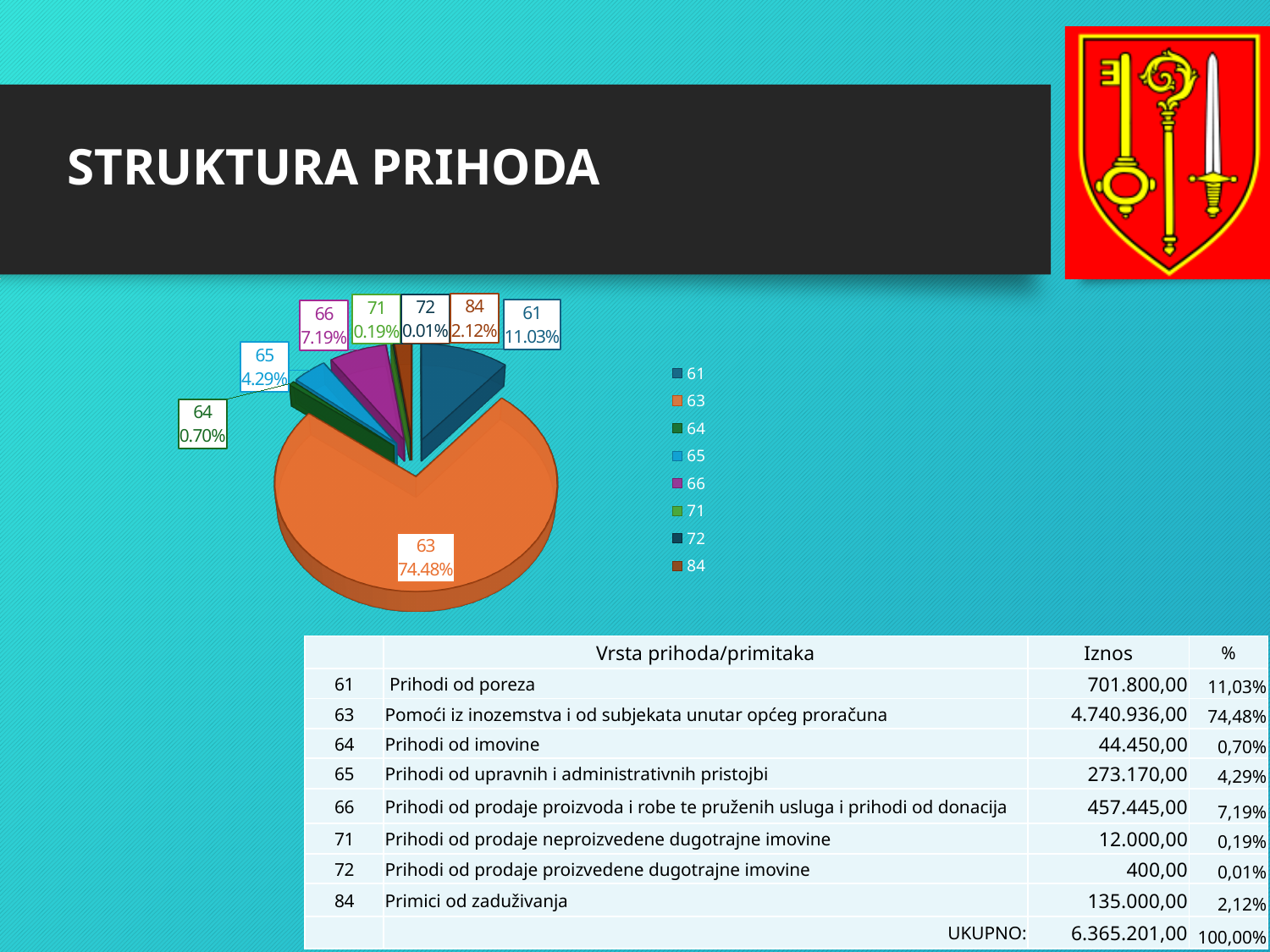
Which category has the largest slice of the pie? 63 What share of the pie does category 63 have? 74.48% What is the value shown for category 65 in the pie chart? 4.29% What is the value shown for category 84 in the pie chart? 2.12% How many slices does the pie chart have? 8 How many entries does the legend of the pie chart list? 8 What is the value shown for category 61 in the pie chart? 11.03% What is the value shown for category 66 in the pie chart? 7.19% Which is larger in the pie chart, the slice for 61 or the slice for 66? 61 What is the difference between the percentage for category 63 and the percentage for category 61? 63.45% What kind of chart is shown on the slide? pie chart Which category has the smallest slice of the pie? 72